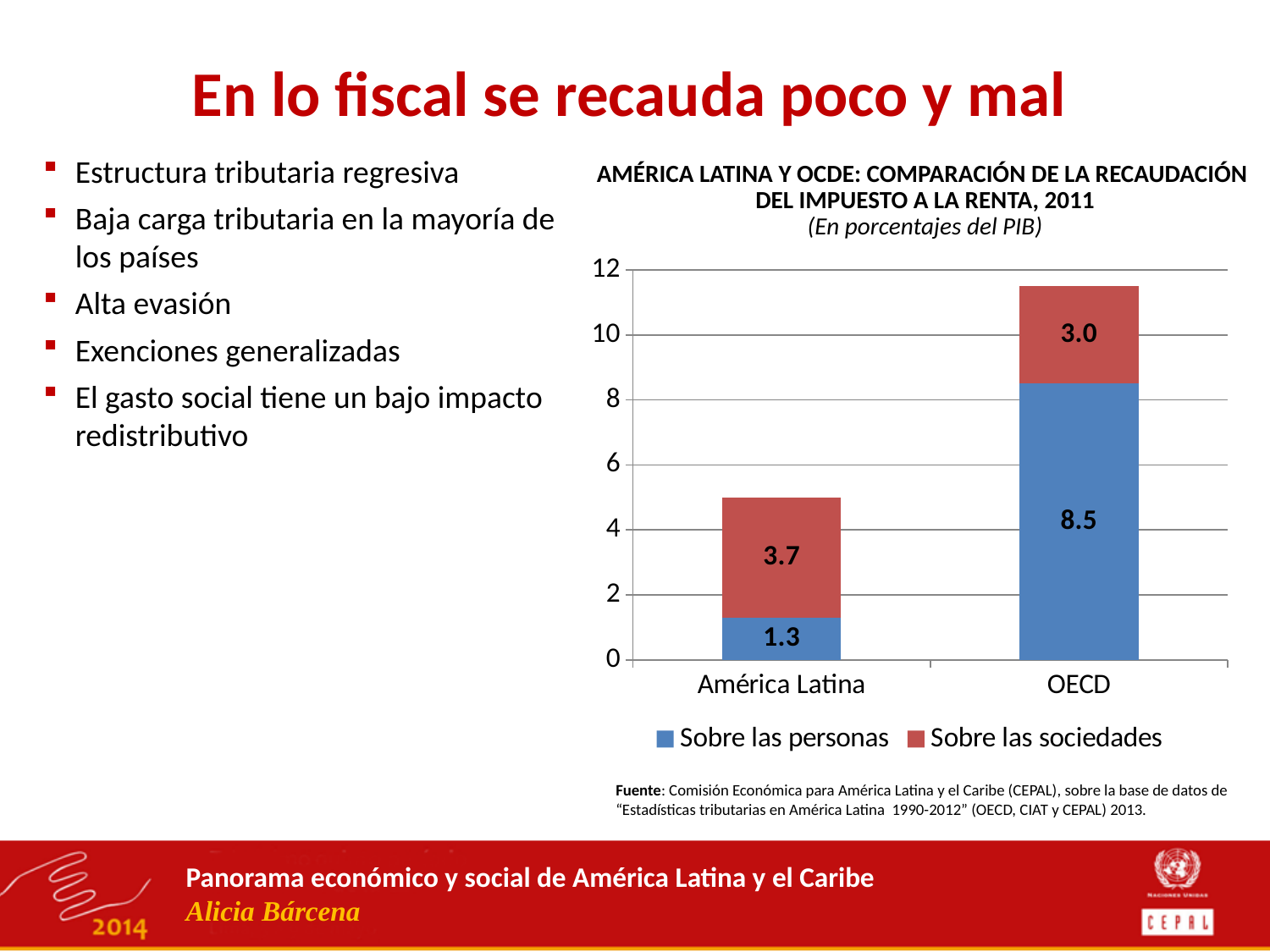
How many categories are shown on the x axis? 2 Which is larger, 'Sobre las sociedades' for América Latina or for OECD? América Latina What is the value for 'Sobre las sociedades' for América Latina? 3.7 How many series does the legend list? 2 What is the total of the stacked bar for América Latina? 5.0 What kind of chart is shown on the slide? Stacked bar chart What is the total of the stacked bar for OECD? 11.5 What is the difference between the 'Sobre las personas' values for OECD and América Latina? 7.2 What is the value for 'Sobre las personas' for América Latina? 1.3 What is the value for 'Sobre las sociedades' for OECD? 3.0 What is the value for 'Sobre las personas' for OECD? 8.5 Which category has the higher 'Sobre las personas' value? OECD